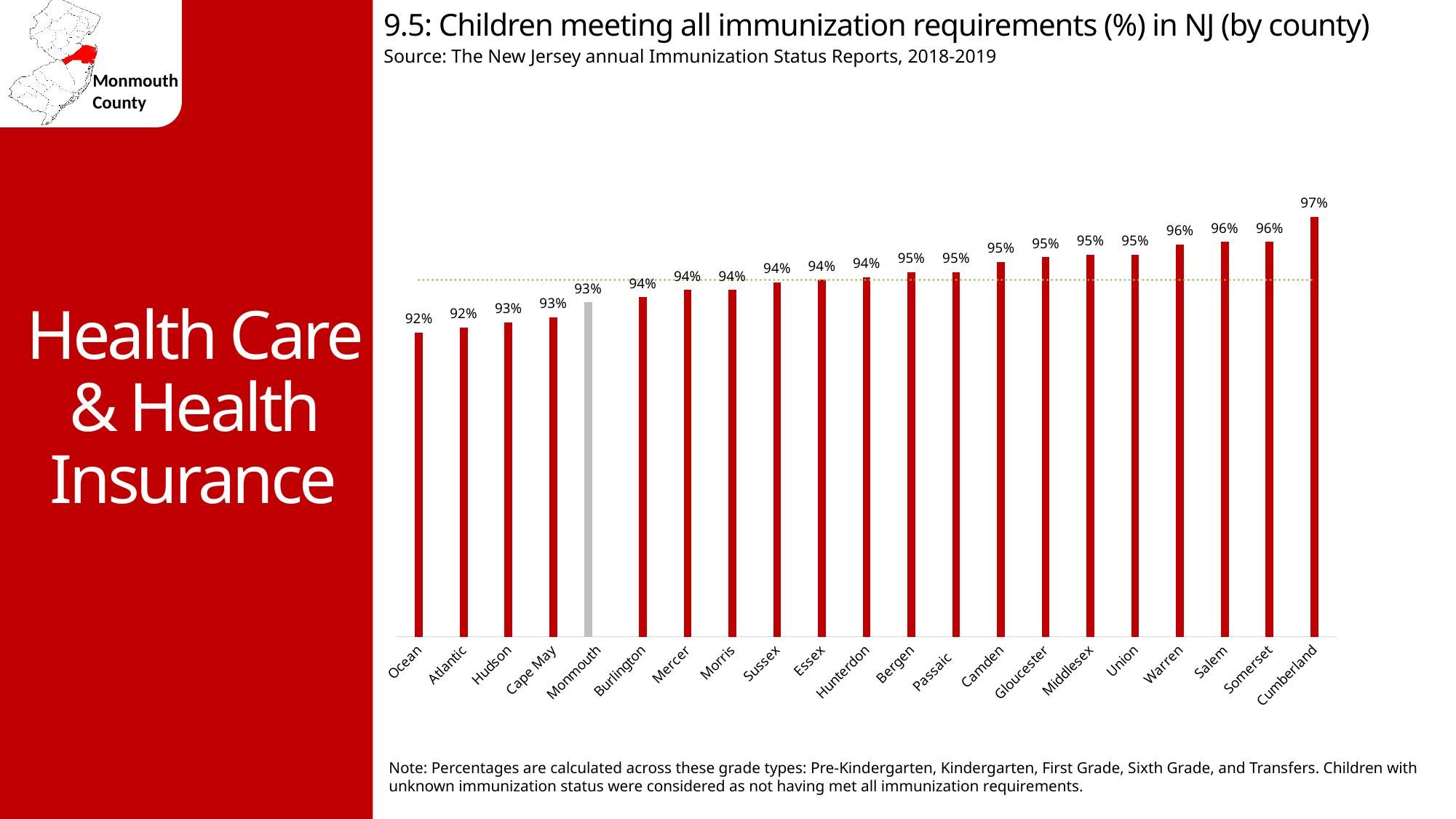
What is the value shown for Ocean County? 92% How many percentage points higher is Cumberland than Ocean? 5 Do the values rise or fall from left to right across the counties? Rise How many counties are shown on the chart? 21 Which has a higher value, Warren or Ocean? Warren What is the value shown for Cumberland County? 97% Which county has the highest percentage of children meeting all immunization requirements? Cumberland What kind of chart is shown on the slide? Bar chart What percentage of children in Monmouth County meet all immunization requirements? 93% What percentage is shown for Bergen County? 95% What is the lowest percentage shown on the chart? 92% How many percentage points higher is Cumberland than Monmouth? 4